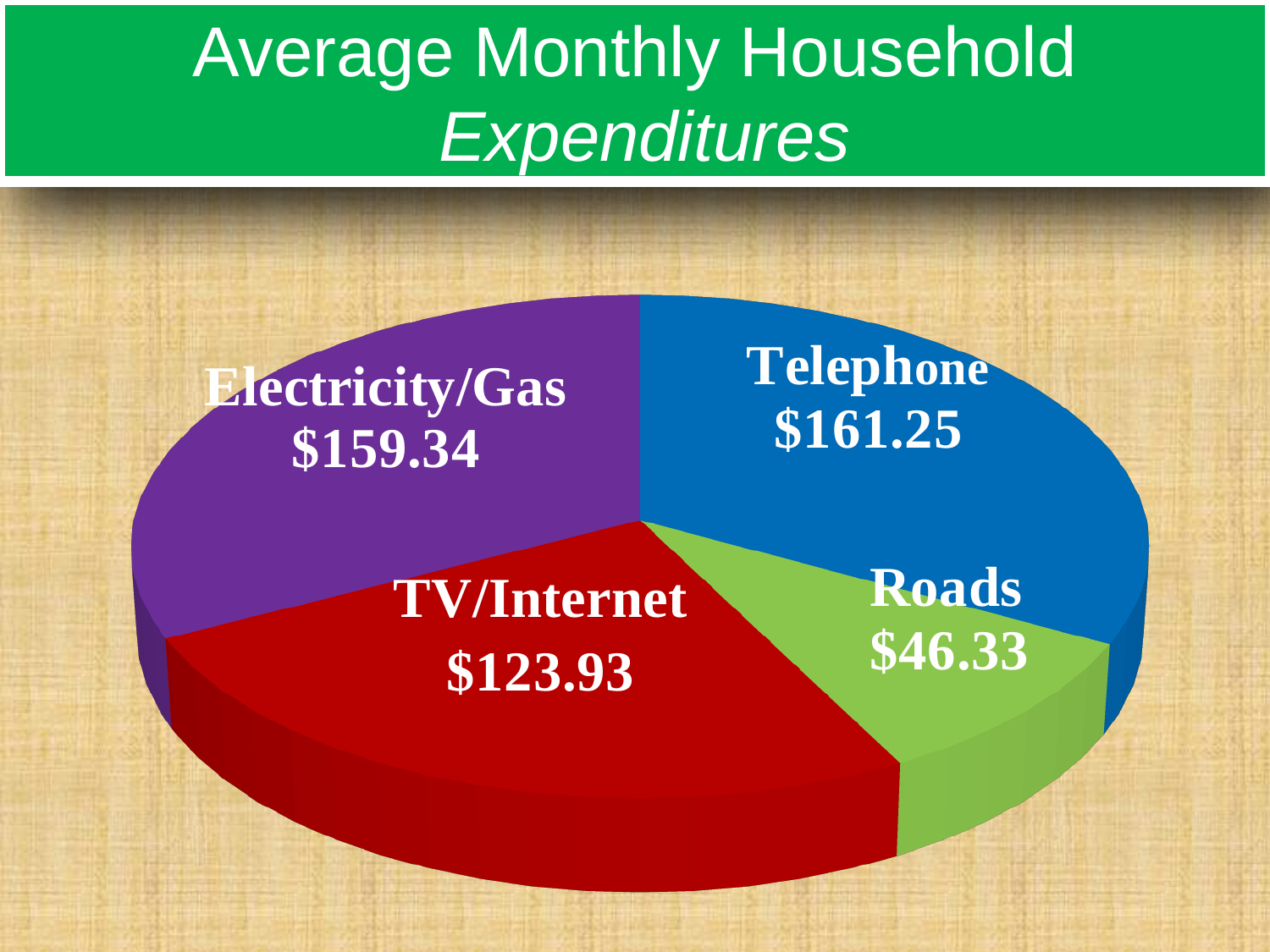
What is the value shown for TV/Internet? $123.93 What is the value shown for Telephone? $161.25 What colour is the Roads slice? Green What type of chart is shown on the slide? Pie chart How many categories does the pie chart show? 4 What is the title of the chart on the slide? Average Monthly Household Expenditures Which is larger, the value for TV/Internet or the value for Roads? TV/Internet What is the value shown for Roads? $46.33 Which category has the highest value? Telephone Which category has the lowest value? Roads What is the difference between the Telephone value and the Electricity/Gas value? $1.91 What is the value shown for Electricity/Gas? $159.34